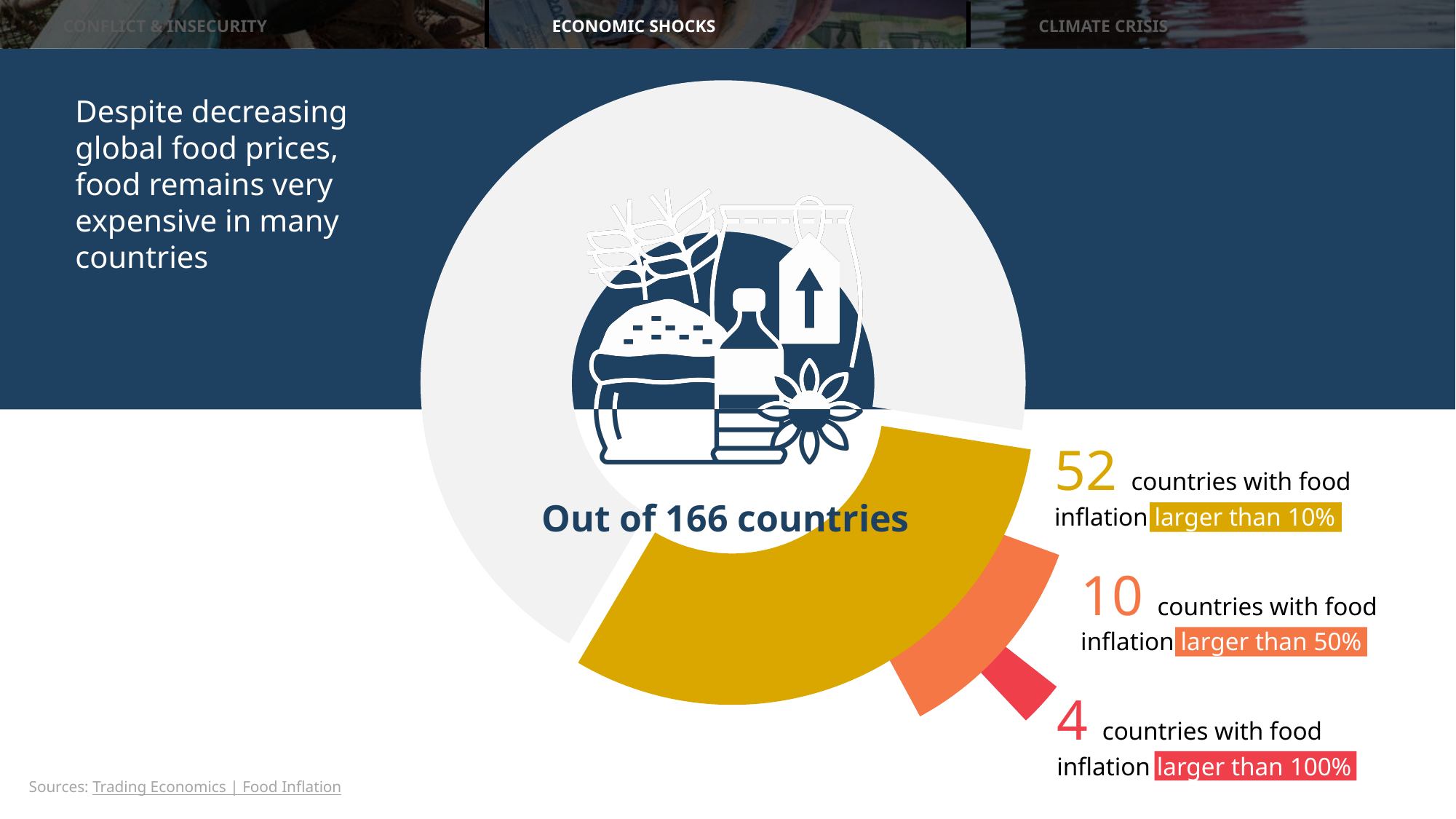
How many labelled segments does the chart have? 3 What kind of chart is shown on the slide? Donut (pie) chart Out of how many countries in total is the chart drawn? 166 Which labelled segment of the chart represents the largest number of countries? Countries with food inflation larger than 10% (52) What colour is the segment for countries with food inflation larger than 100%? Red Which is larger: the number of countries with food inflation larger than 50% or the number with food inflation larger than 100%? Larger than 50% (10) How many countries have food inflation larger than 10%? 52 Which labelled segment of the chart represents the smallest number of countries? Countries with food inflation larger than 100% (4) What is the difference between the number of countries with food inflation larger than 10% and those with food inflation larger than 50%? 42 How many countries have food inflation larger than 50%? 10 What is the difference between the number of countries with food inflation larger than 50% and those with food inflation larger than 100%? 6 How many countries have food inflation larger than 100%? 4